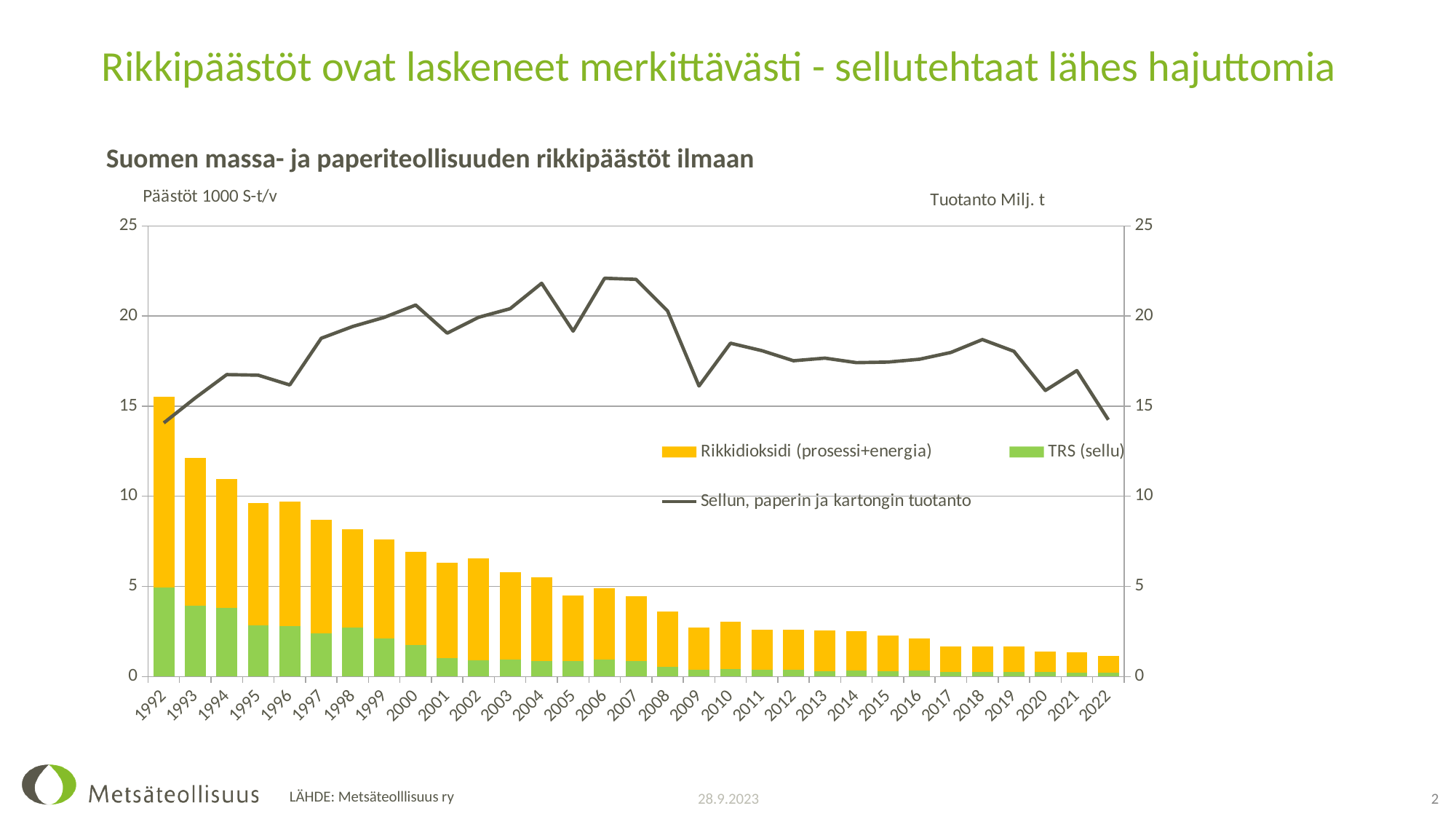
What is the title of the chart? Suomen massa- ja paperiteollisuuden rikkipäästöt ilmaan How many series does the chart's legend list? 3 Do the emissions bars rise or fall from 1992 to 2022? Fall Is the value of the production line (Sellun, paperin ja kartongin tuotanto) in 2022 greater or less than 15? less Which year has the larger total emissions bar, 1993 or 1994? 1993 What kind of chart is shown on the slide? A stacked bar chart combined with a line Is the value of the production line (Sellun, paperin ja kartongin tuotanto) in 2006 greater or less than 20? greater Which year has the lowest total emissions bar? 2022 How many years are shown along the x axis of the chart? 31 Which year has the highest total emissions bar? 1992 Is the total emissions bar for 1993 greater or less than 10? greater